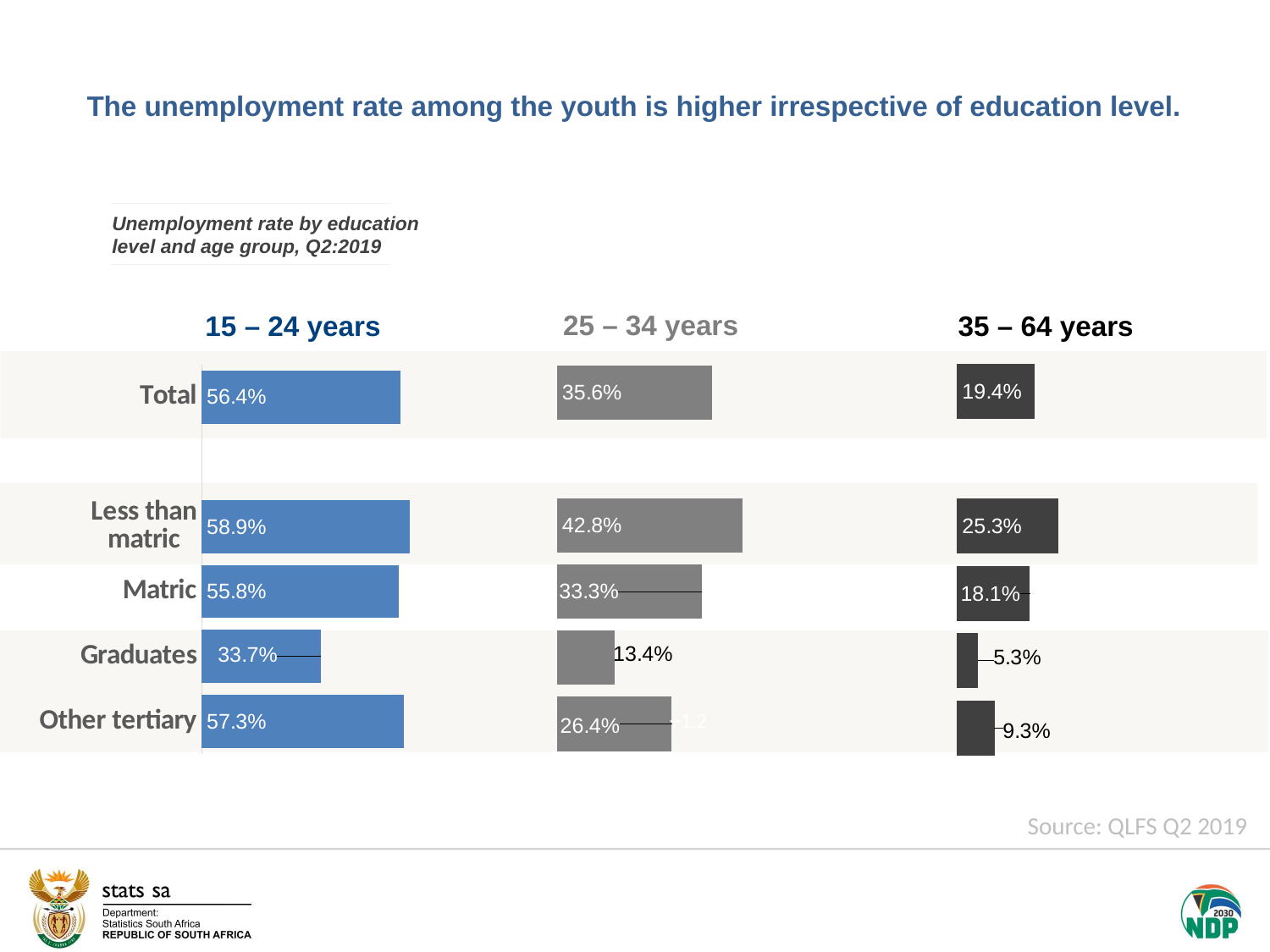
What kind of chart is shown on the slide? Bar chart Which education level has the lowest unemployment rate in the 35 – 64 years age group? Graduates Which education level has the highest unemployment rate in the 15 – 24 years age group? Less than matric How many age groups are shown in the chart? 3 What is the Total unemployment rate for the 35 – 64 years age group? 19.4% What is the title of the chart? Unemployment rate by education level and age group, Q2:2019 What is the unemployment rate for Graduates aged 15 – 24 years? 33.7% What is the unemployment rate for Other tertiary in the 35 – 64 years age group? 9.3% What is the difference between the Total unemployment rate for 15 – 24 years and for 35 – 64 years? 37.0% What is the unemployment rate for Matric in the 25 – 34 years age group? 33.3% How many education-level categories (including Total) are shown in the chart? 5 Which is larger: the unemployment rate for Graduates aged 25 – 34 years or for Other tertiary aged 25 – 34 years? Other tertiary aged 25 – 34 years